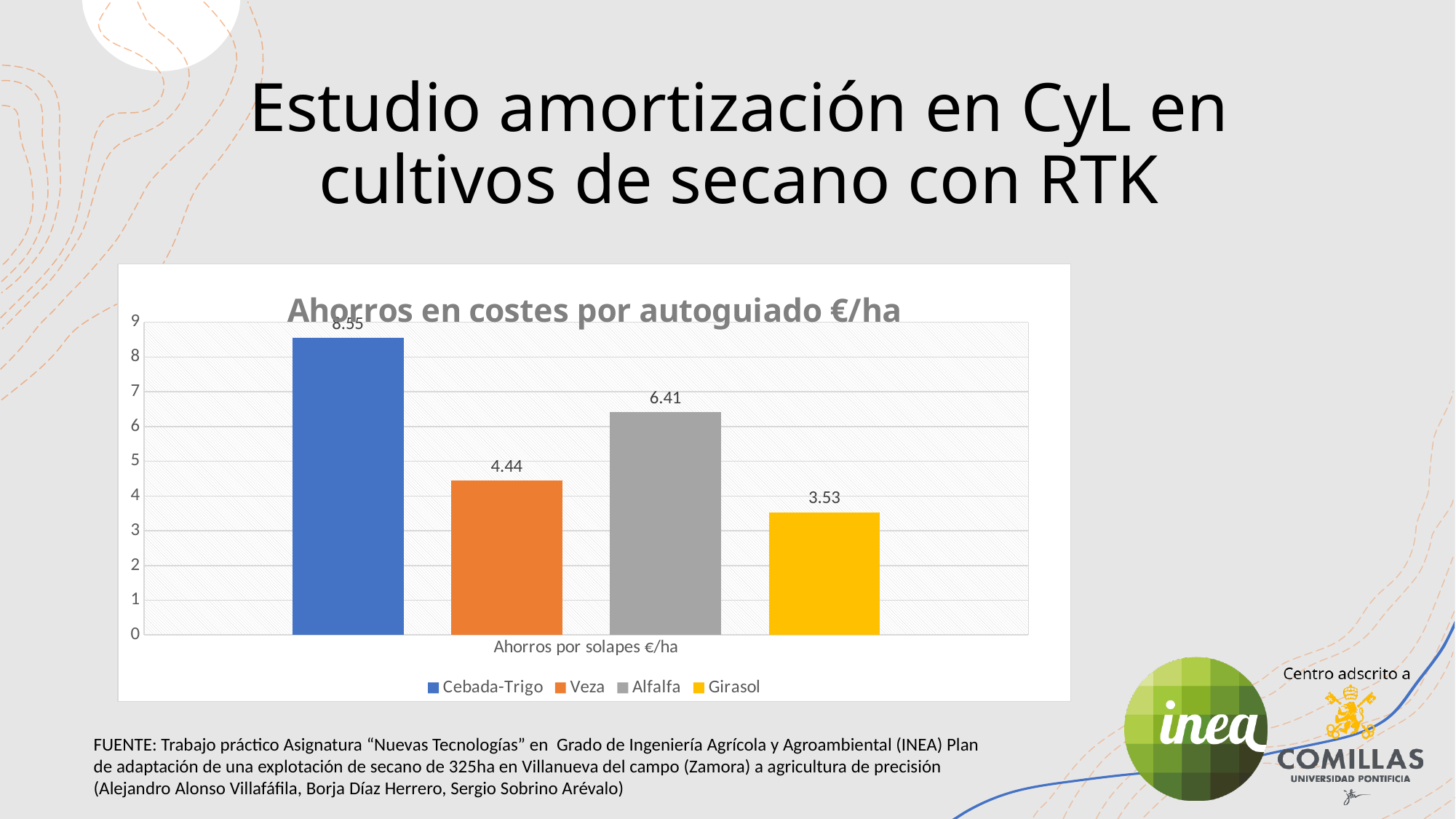
How many series does the legend list? 4 What is the value for Alfalfa? 6.41 What is the title of the chart? Ahorros en costes por autoguiado €/ha Is the value for Girasol greater or less than 4? less What is the value for Cebada-Trigo? 8.55 What kind of chart is shown? bar chart Which series has the highest value? Cebada-Trigo Which series has the lowest value? Girasol What is the value for Veza? 4.44 Which is larger, the value for Veza or the value for Alfalfa? Alfalfa What is the value for Girasol? 3.53 What is the difference between the values for Cebada-Trigo and Alfalfa? 2.14